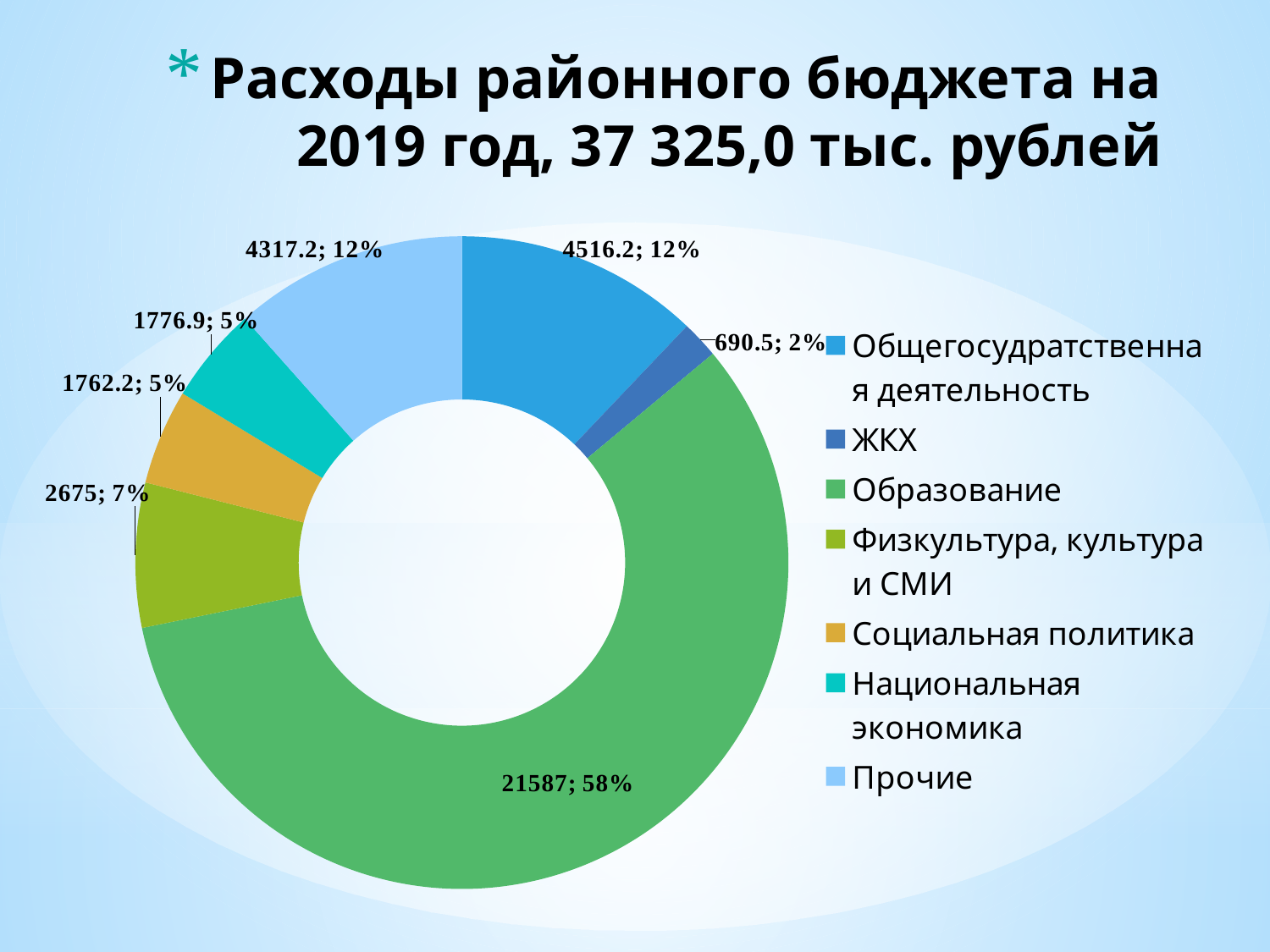
What is the value shown for Национальная экономика? 1776.9 What percentage share does Общегосударственная деятельность have? 12% What type of chart is shown on the slide? Doughnut (pie) chart What percentage share does Физкультура, культура и СМИ have? 7% What is the value shown for Образование? 21587 What is the difference between the values for Общегосударственная деятельность and Прочие? 199 Which is larger, the value for Социальная политика or the value for Физкультура, культура и СМИ? Физкультура, культура и СМИ Which category has the smallest share of the budget expenses? ЖКХ What is the value shown for ЖКХ? 690.5 What is the value shown for Прочие? 4317.2 Which category has the largest share of the budget expenses? Образование How many categories does the legend list? 7